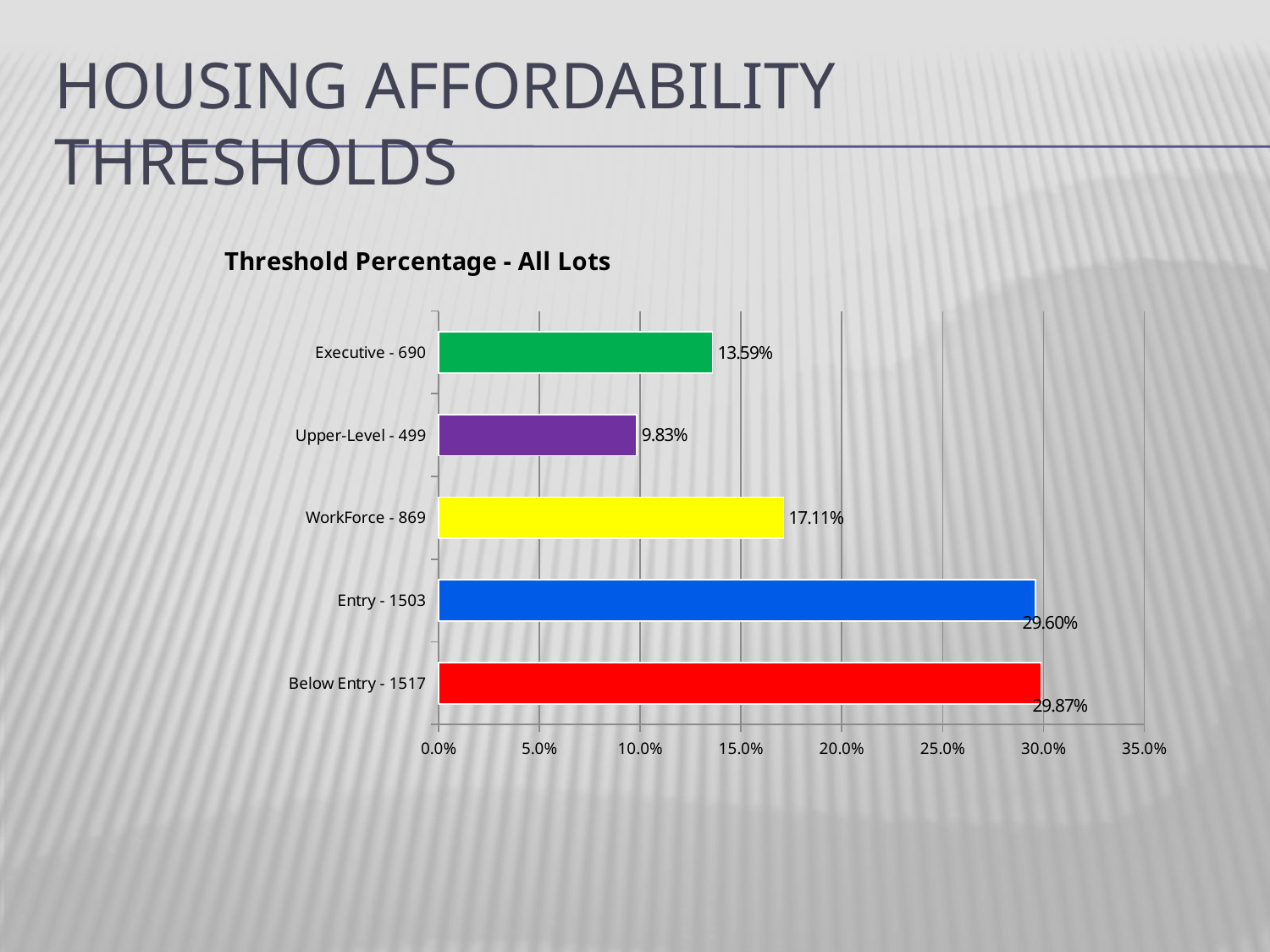
What is the difference between the values for Below Entry - 1517 and Entry - 1503? 0.27% Which is larger, the value for WorkForce - 869 or the value for Executive - 690? WorkForce - 869 Which category has the lowest threshold percentage? Upper-Level - 499 What is the value for WorkForce - 869? 17.11% What kind of chart is shown on the slide? bar chart What is the difference between the values for WorkForce - 869 and Executive - 690? 3.52% How many categories are shown in the chart? 5 What is the value for Executive - 690? 13.59% What is the value for Upper-Level - 499? 9.83% What is the value for Below Entry - 1517? 29.87% Is the value for Executive - 690 greater or less than 15.0%? less Which category has the highest threshold percentage? Below Entry - 1517